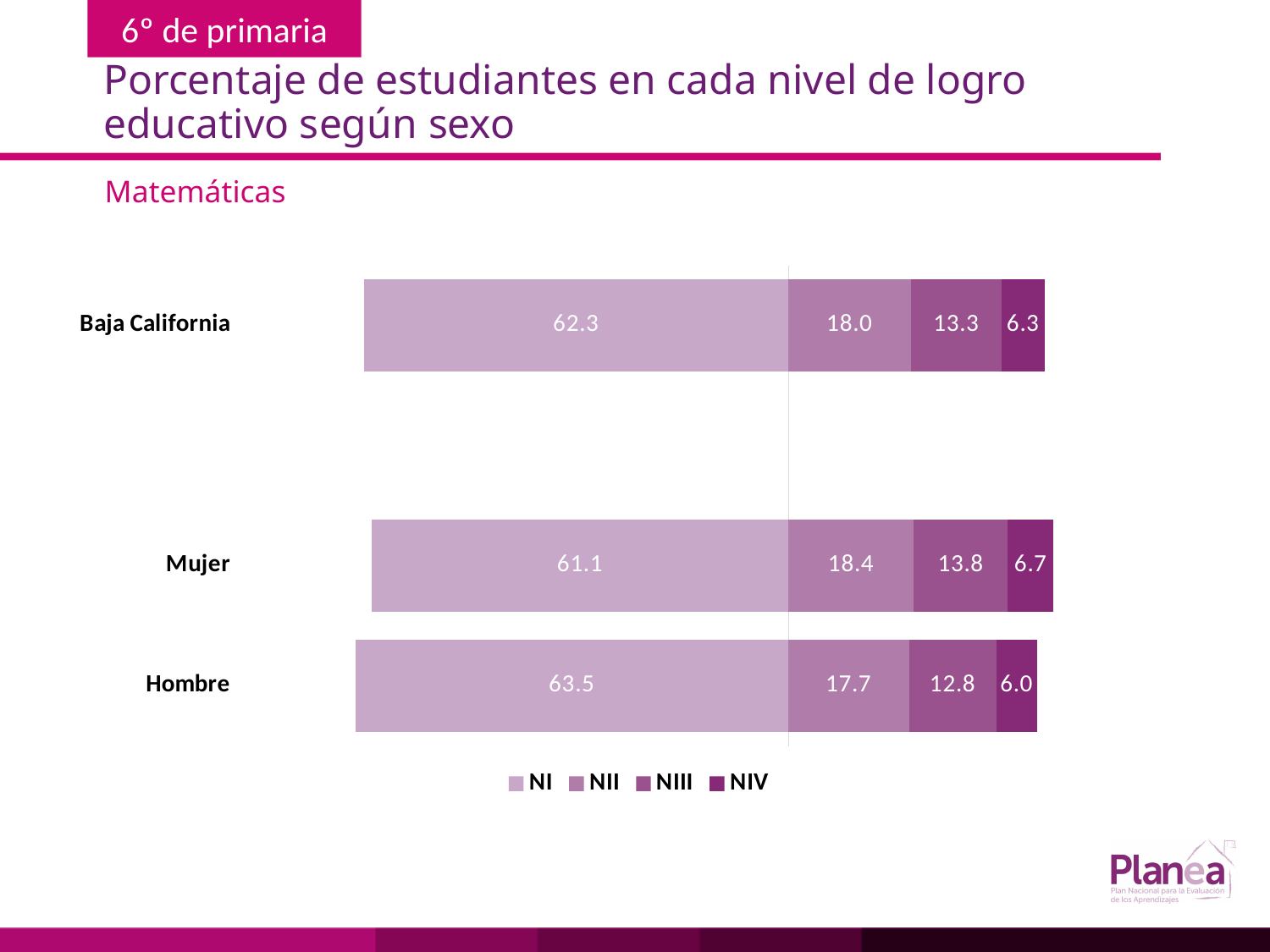
What is the NII value for Hombre? 17.7 What is the NIV value for Mujer? 6.7 How many series does the legend list? 4 What is the difference between the NI values for Hombre and Mujer? 2.4 How many categories are shown on the chart? 3 What is the NI value for Baja California? 62.3 Which is larger, the NIII value for Baja California or for Hombre? Baja California What is the NIII value for Mujer? 13.8 Which category has the lowest NIV value? Hombre What kind of chart is shown on the slide? Stacked bar chart Which category has the highest NI value? Hombre What is the total of the stacked bar for Mujer? 100.0